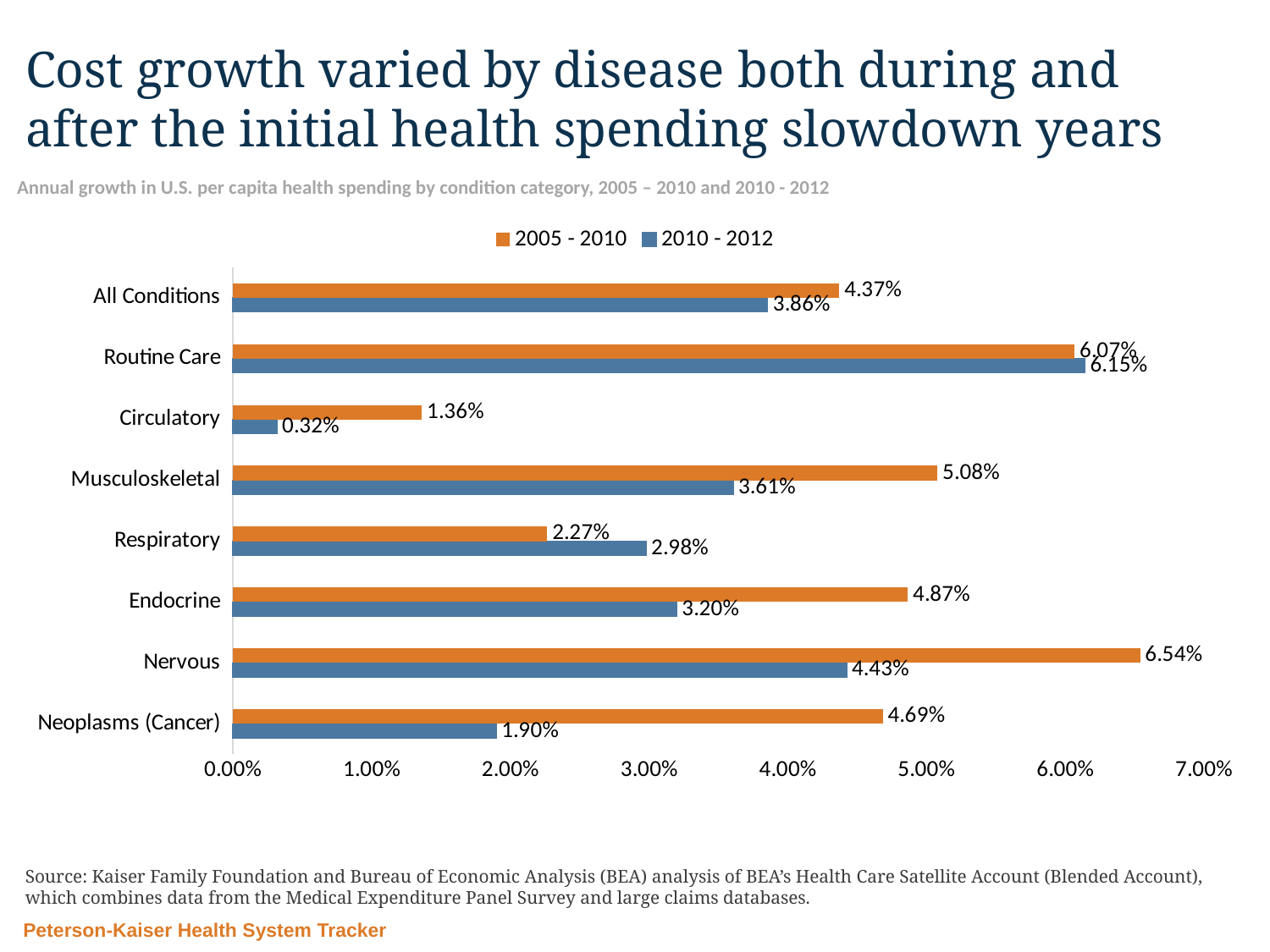
How many condition categories are shown in the chart? 8 What was the annual growth in per capita health spending for Nervous conditions in 2005 - 2010? 6.54% What is the difference between the 2005 - 2010 and 2010 - 2012 growth rates for Nervous conditions? 2.11 percentage points Which condition category had the highest annual growth in 2005 - 2010? Nervous What was the annual growth for Neoplasms (Cancer) in 2010 - 2012? 1.90% Which condition category had the highest annual growth in 2010 - 2012? Routine Care How many series does the legend list? 2 Is the 2010 - 2012 growth for Musculoskeletal conditions greater or less than 4.00%? less Which condition category had the lowest annual growth in 2010 - 2012? Circulatory What type of chart is shown on the slide? Bar chart For Respiratory conditions, which period had the higher annual growth, 2005 - 2010 or 2010 - 2012? 2010 - 2012 What was the annual growth for All Conditions in 2005 - 2010? 4.37%